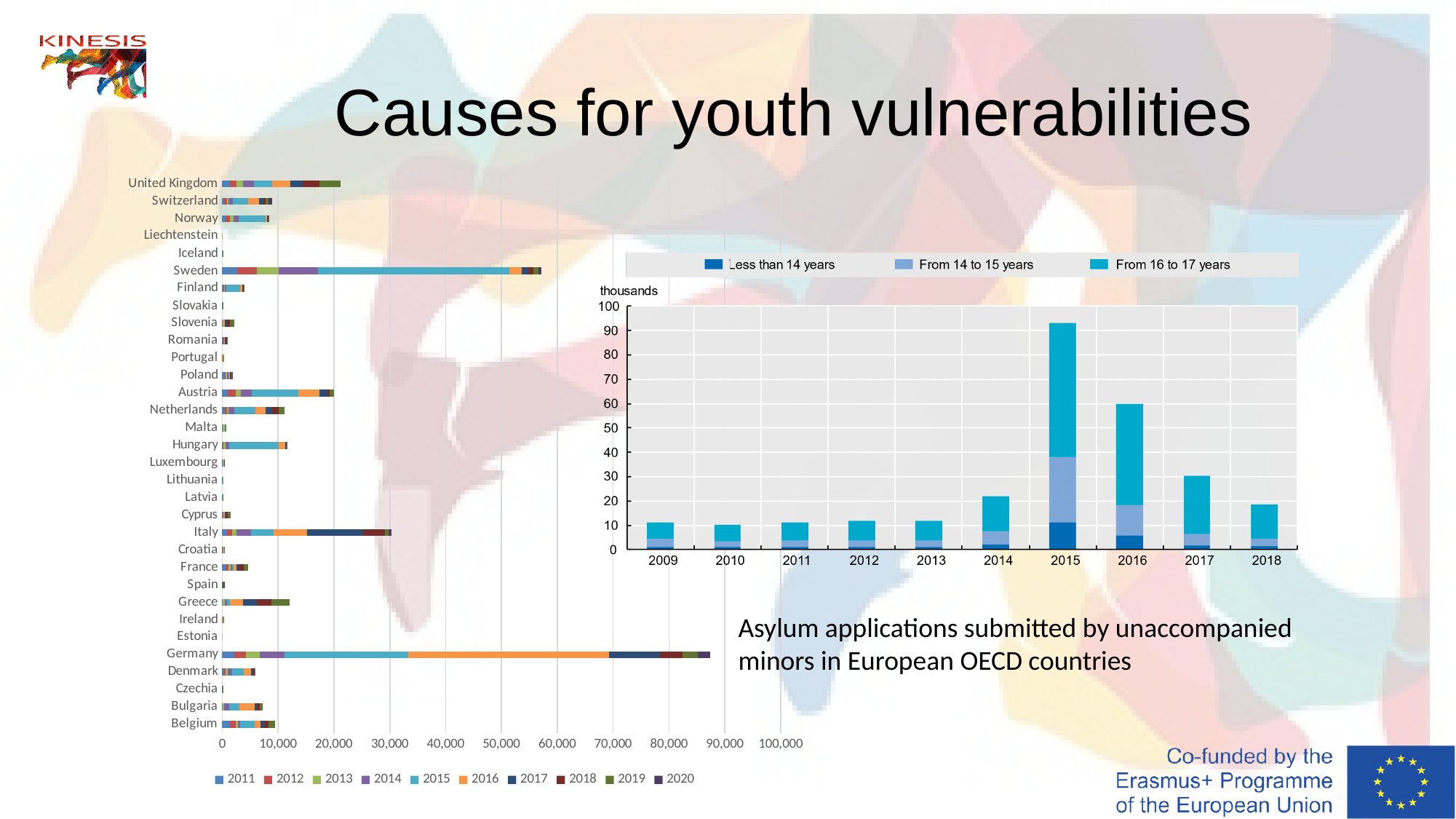
How many series does the legend of the right chart (asylum applications by unaccompanied minors) list? 3 On the left chart, is the total value for Italy greater or less than 20,000? greater On the right chart (asylum applications by unaccompanied minors), which year has the larger total, 2016 or 2017? 2016 On the left chart, is the total value for Sweden greater or less than 50,000? greater How many countries are listed on the left chart? 32 On the left chart, which has the larger total, Sweden or Italy? Sweden How many series does the legend of the left chart list? 10 On the left chart, which country has the longest bar? Germany On the left chart, is the total value for Germany greater or less than 80,000? greater On the right chart (asylum applications by unaccompanied minors), which year has the highest total? 2015